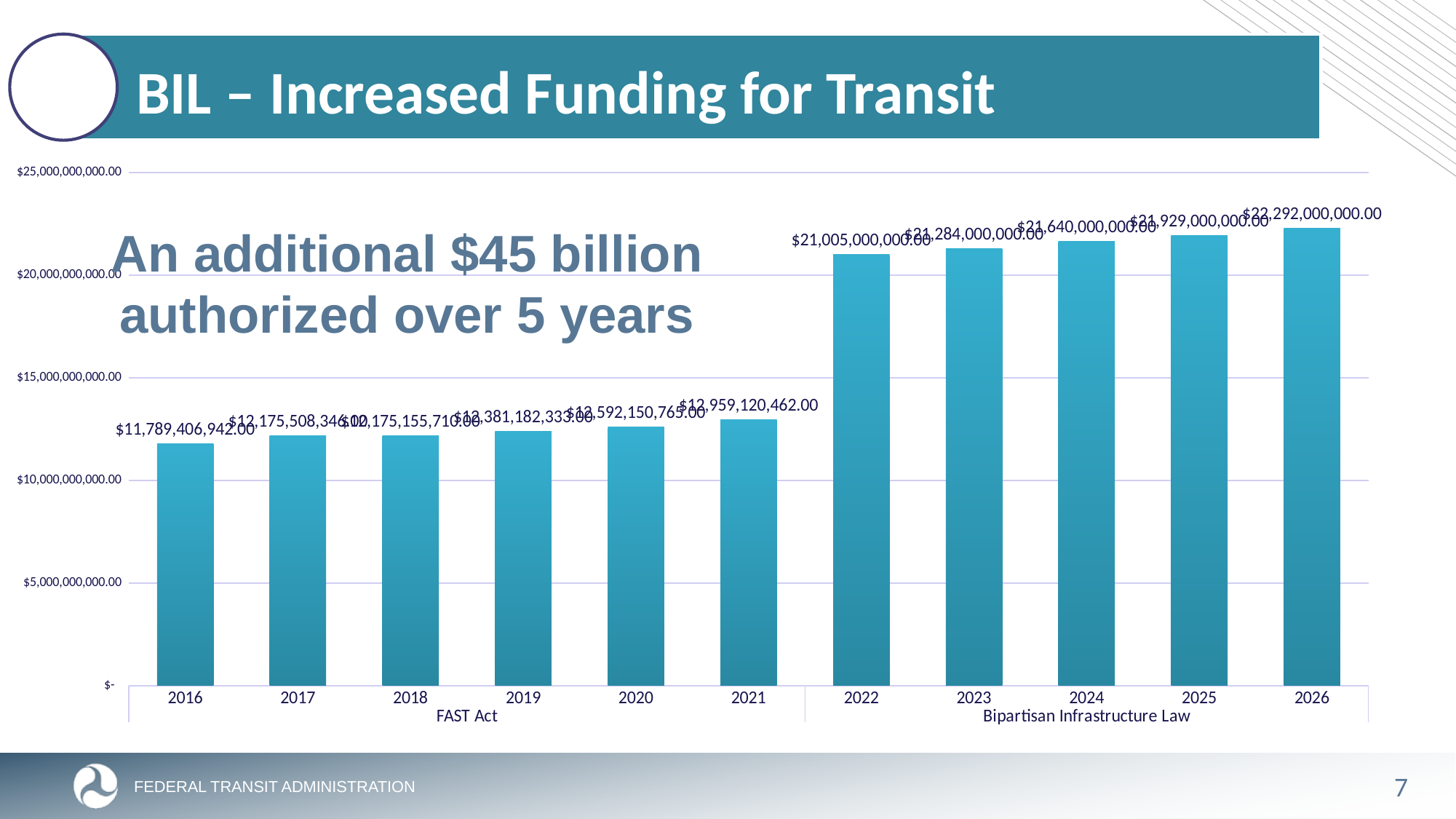
Which year has the lowest funding value? 2016 Which year has the highest funding value? 2026 What is the difference between the 2022 value and the 2021 value? $8,045,879,538.00 What is the funding value shown for 2021? $12,959,120,462.00 Is the value for 2023 greater or less than $20,000,000,000.00? greater What is the funding value shown for 2026? $22,292,000,000.00 What kind of chart is shown on the slide? Bar chart How many years are plotted on the chart? 11 Which is larger, the value for 2021 or the value for 2022? 2022 What is the funding value shown for 2022? $21,005,000,000.00 Which two groups are the years divided into on the x axis? FAST Act and Bipartisan Infrastructure Law What is the funding value shown for 2016? $11,789,406,942.00